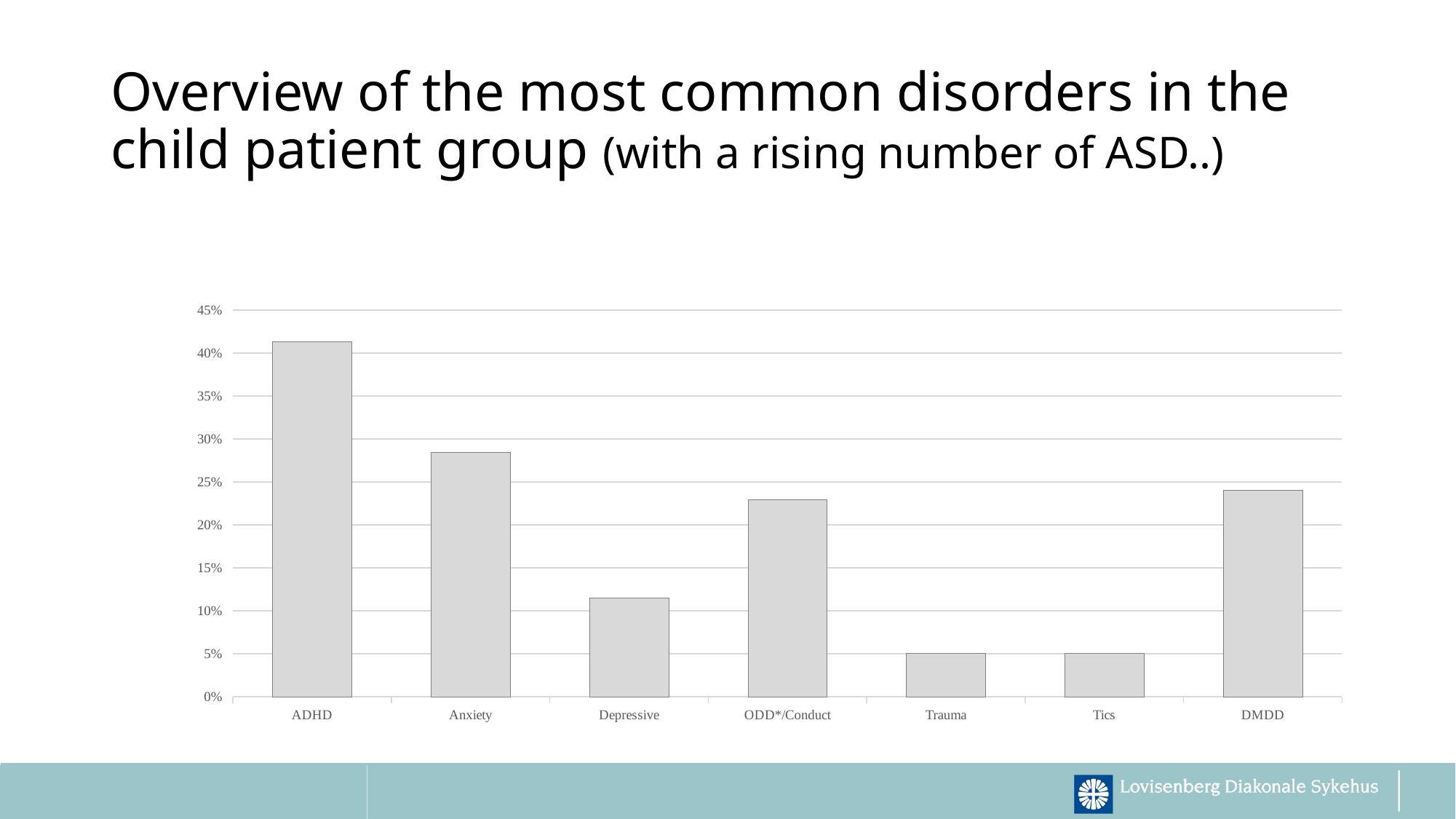
How many disorder categories are shown on the x axis of the chart? 7 Is the value for DMDD greater or less than 20%? greater What kind of chart is shown on the slide? bar chart Which has a larger value, Depressive or DMDD? DMDD Which has a larger value, Anxiety or ODD*/Conduct? Anxiety Is the value for Anxiety greater or less than 30%? less Is the value for ADHD greater or less than 40%? greater What is the highest value shown on the y axis of the chart? 45% Which disorder has the highest value in the chart? ADHD